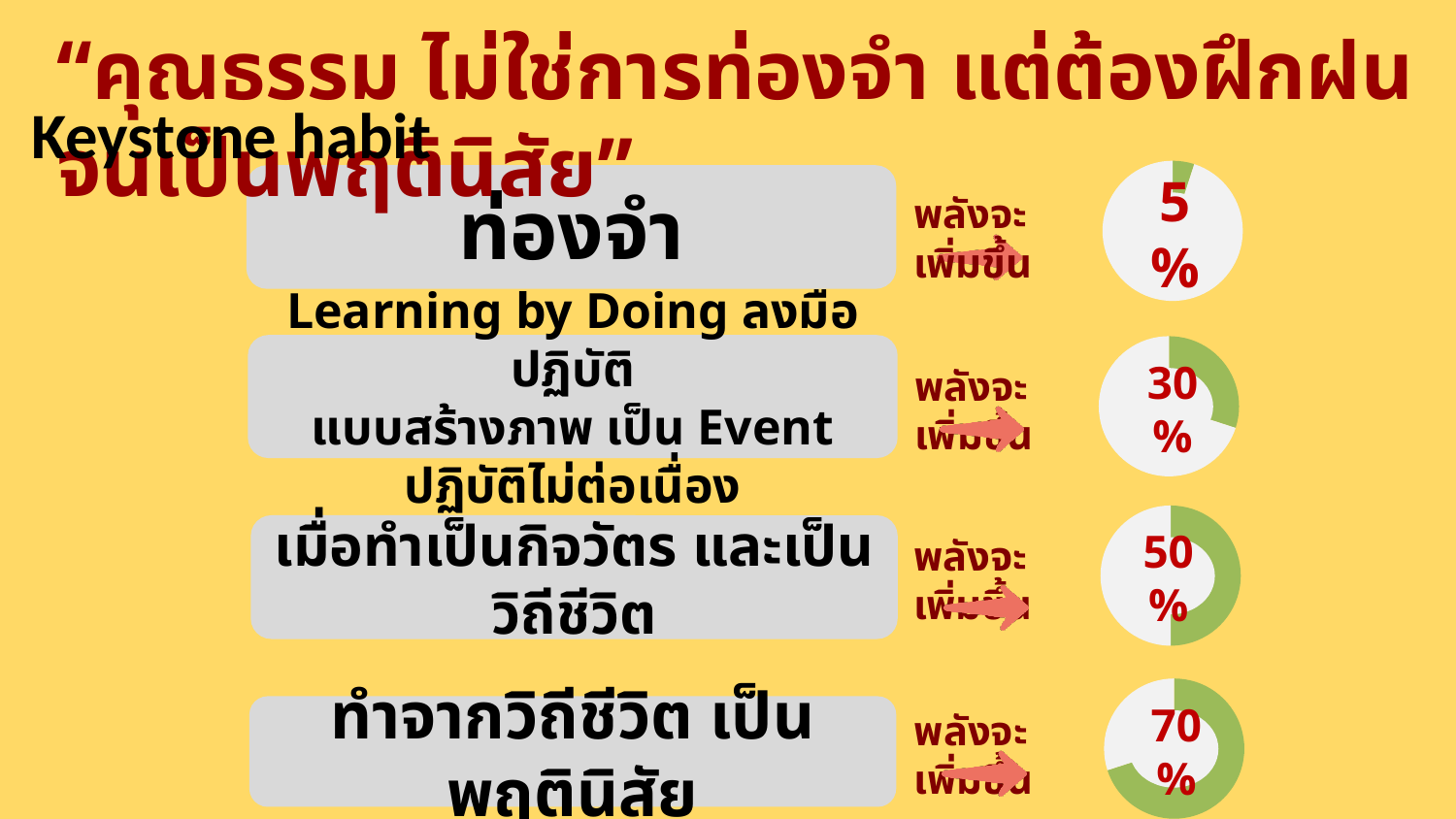
Do the percentages in the doughnut charts increase or decrease going from the top of the slide to the bottom? Increase How many doughnut charts are on the slide? 4 What is the difference between the percentage in the bottom doughnut chart and the percentage in the top doughnut chart? 65% What percentage is shown in the second doughnut chart from the top, next to "Learning by Doing"? 30% Which stage has the highest percentage in its doughnut chart? ทำจากวิถีชีวิต เป็นพฤตินิสัย (70%) What colour is the filled portion of the doughnut charts? Green What percentage is shown in the topmost doughnut chart, next to "ท่องจำ"? 5% What kind of chart is used on the right side of the slide to show the percentages? Doughnut chart Which stage has the lowest percentage in its doughnut chart? ท่องจำ (5%) What percentage is shown in the bottom doughnut chart, next to "ทำจากวิถีชีวิต เป็นพฤตินิสัย"? 70% What percentage is shown in the third doughnut chart from the top, next to "เมื่อทำเป็นกิจวัตร และเป็นวิถีชีวิต"? 50% Which is larger: the percentage in the second doughnut chart from the top or the third doughnut chart from the top? The third (50%)